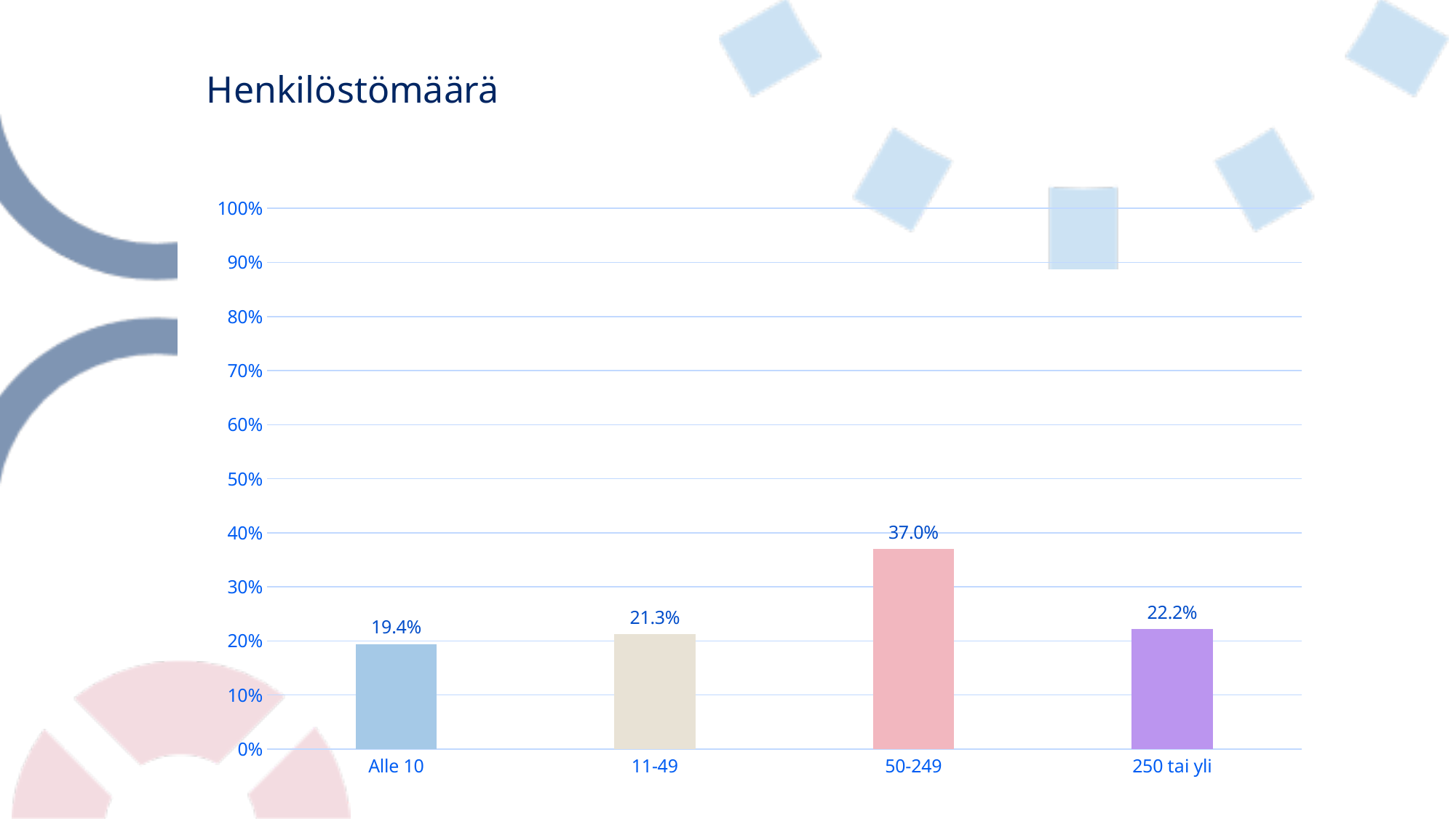
How many categories are shown on the x axis? 4 Which category has the highest value? 50-249 What is the value for the "50-249" category? 37.0% What is the value for the "11-49" category? 21.3% Which category has the lowest value? Alle 10 What kind of chart is shown on the slide? Bar chart What is the value for the "Alle 10" category? 19.4% Which is larger, the value for "250 tai yli" or the value for "11-49"? 250 tai yli What is the value for the "250 tai yli" category? 22.2% Is the value for "50-249" greater or less than 30%? greater What is the title of the slide? Henkilöstömäärä What is the difference between the values for "50-249" and "Alle 10"? 17.6%